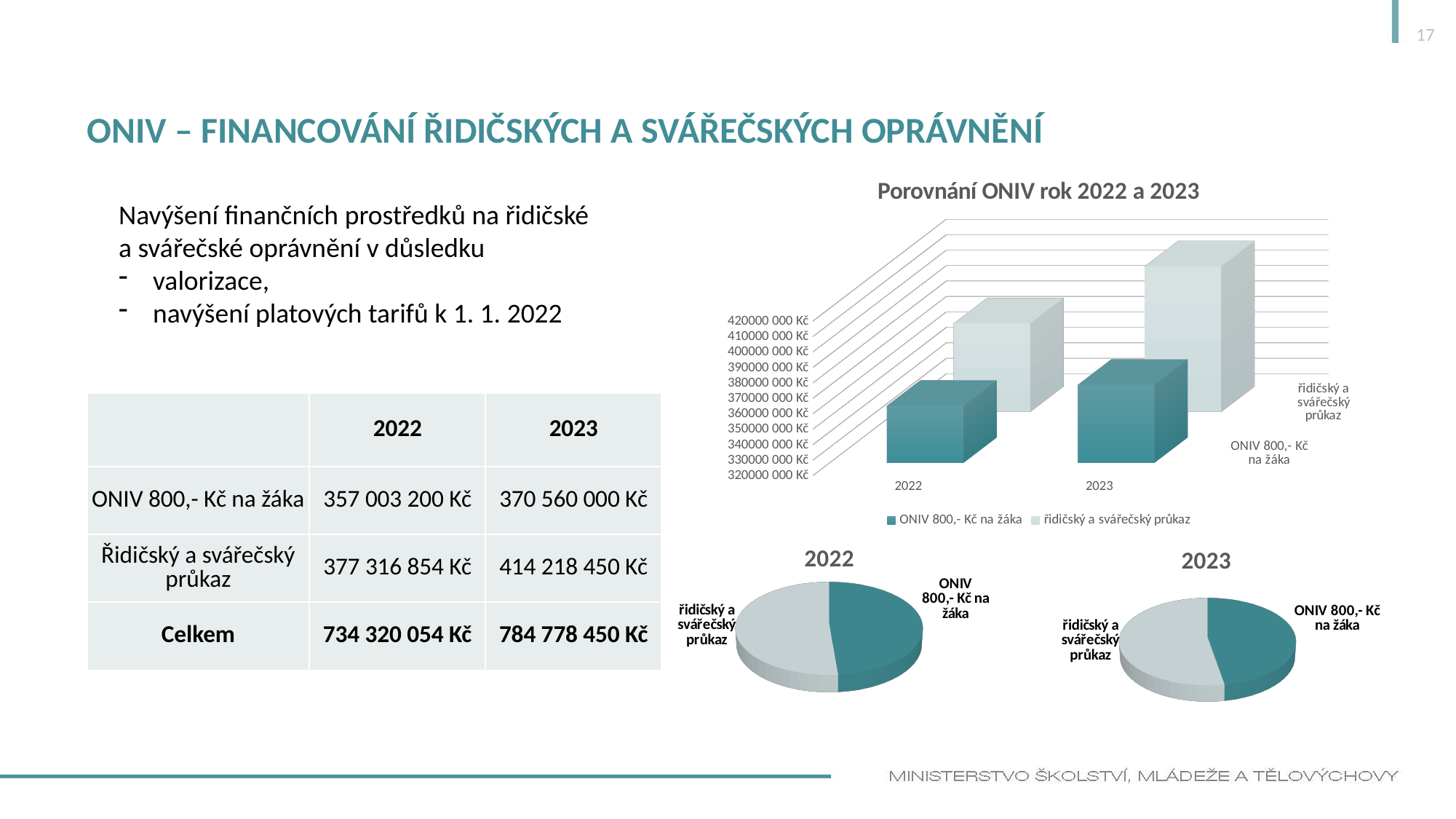
In the chart "Porovnání ONIV rok 2022 a 2023", is the value for řidičský a svářečský průkaz in 2023 greater or less than 400000 000 Kč? greater In the chart "Porovnání ONIV rok 2022 a 2023", how many years are shown on the x axis? 2 In the chart "Porovnání ONIV rok 2022 a 2023", which bar is the lowest? ONIV 800,- Kč na žáka in 2022 In the chart "Porovnání ONIV rok 2022 a 2023", is the value for ONIV 800,- Kč na žáka in 2023 greater or less than 380000 000 Kč? less In the chart "Porovnání ONIV rok 2022 a 2023", does the value for ONIV 800,- Kč na žáka rise or fall from 2022 to 2023? rise In the pie chart titled "2023", which slice is larger? řidičský a svářečský průkaz In the chart "Porovnání ONIV rok 2022 a 2023", which bar is the highest? řidičský a svářečský průkaz in 2023 In the chart "Porovnání ONIV rok 2022 a 2023", how many series does the legend list? 2 In the chart "Porovnání ONIV rok 2022 a 2023", what are the two legend entries? ONIV 800,- Kč na žáka; řidičský a svářečský průkaz What kind of chart is the chart titled "Porovnání ONIV rok 2022 a 2023"? bar chart In the chart "Porovnání ONIV rok 2022 a 2023", which series has the larger value in 2023? řidičský a svářečský průkaz What kind of chart is the chart titled "2023" at the bottom right of the slide? pie chart